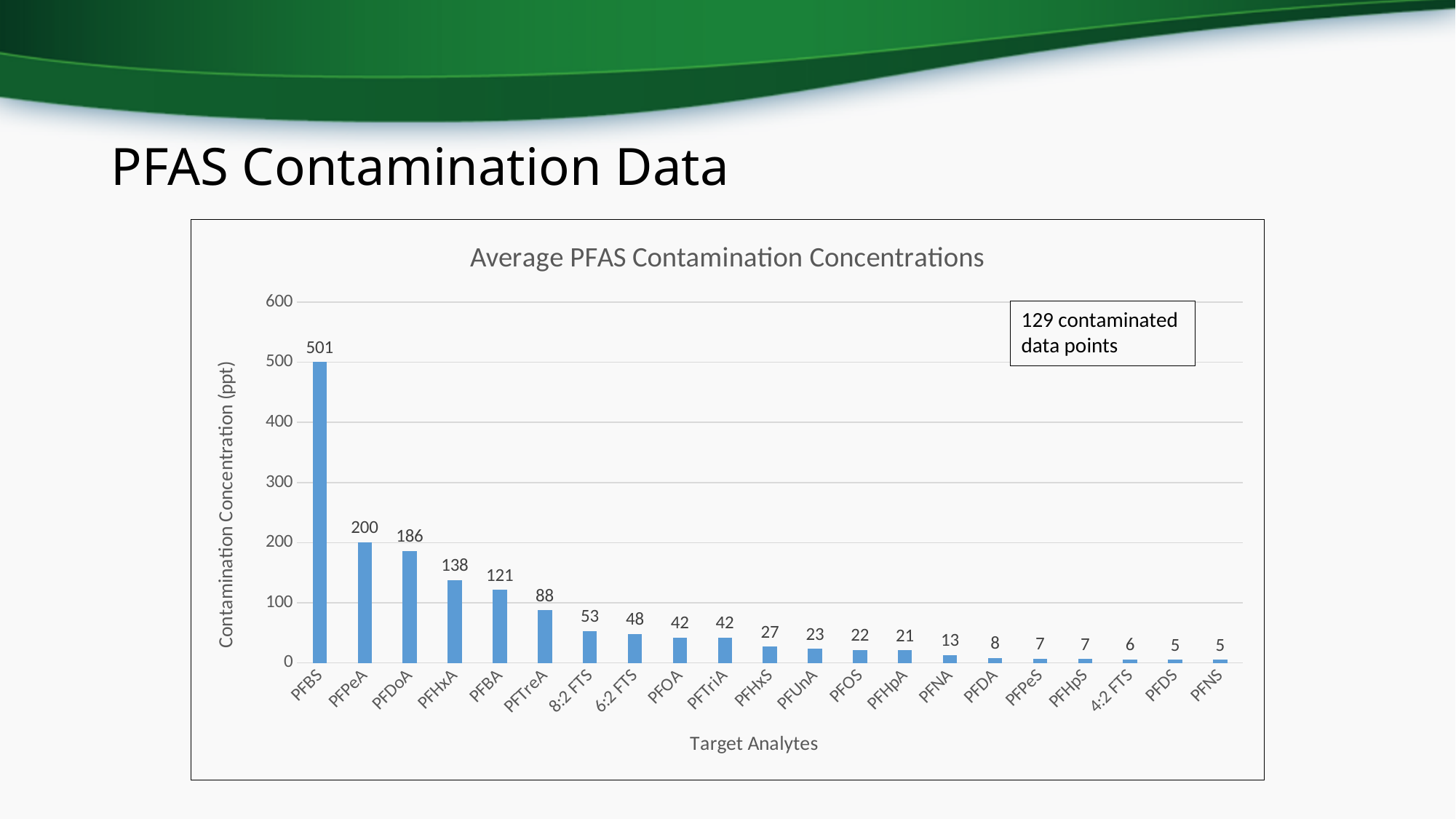
What is the value shown for 6:2 FTS? 48 What is the difference between the values for PFPeA and PFDoA? 14 Is the value for PFPeA greater or less than 100? greater What kind of chart is shown on the slide? Bar chart Which target analyte has the highest average contamination concentration? PFBS What is the label of the y axis? Contamination Concentration (ppt) What is the difference between the values for PFBS and PFBA? 380 How many target analytes are shown on the x axis? 21 What is the average contamination concentration for PFBS? 501 What is the value shown for PFOS? 22 Which has a larger value, PFTreA or 8:2 FTS? PFTreA What is the value shown for PFHxA? 138